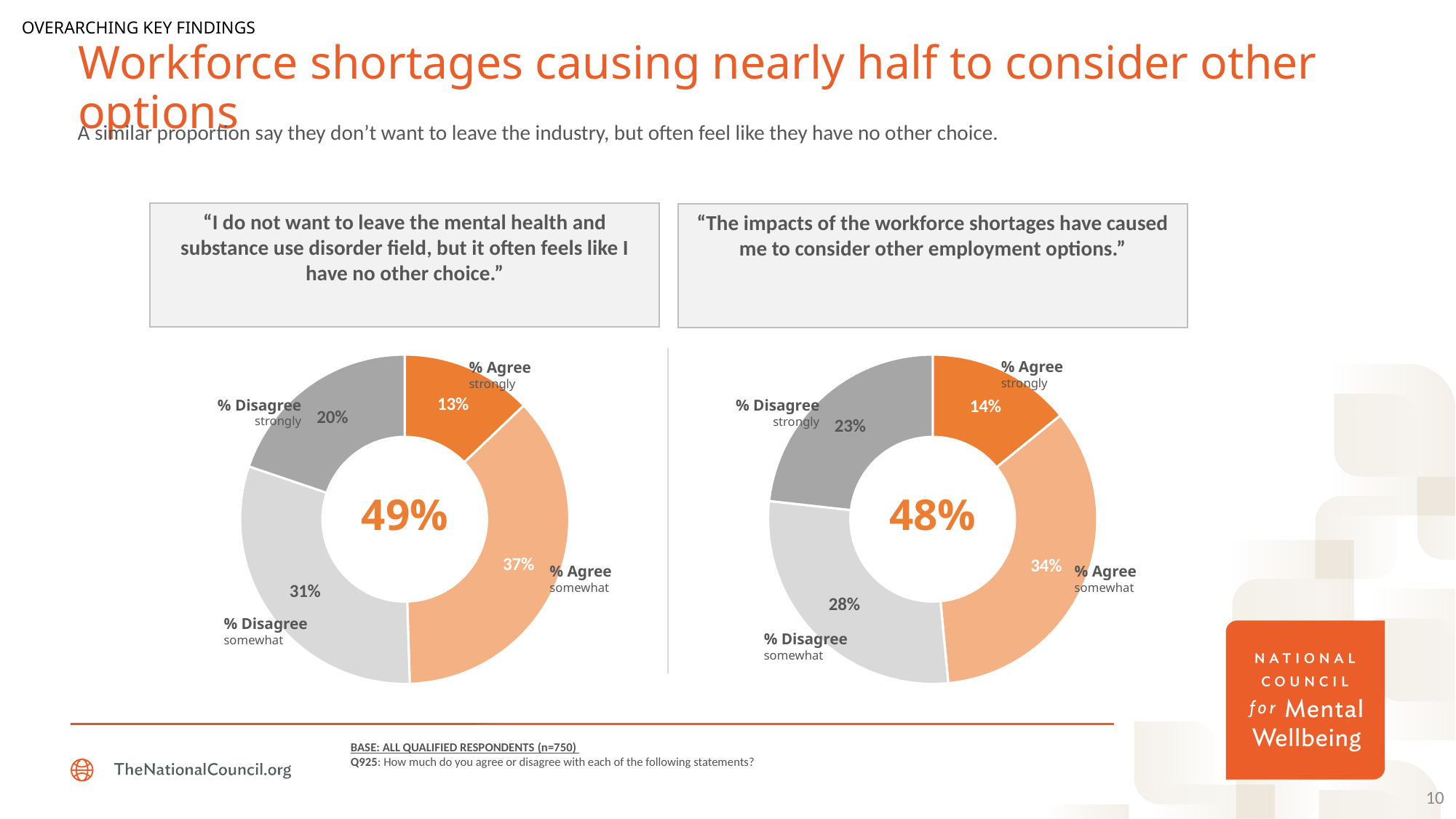
In the left chart ("I do not want to leave..."), what percentage of respondents agree strongly? 13% How many response categories does each donut chart on the slide show? 4 In the left chart ("I do not want to leave the mental health and substance use disorder field..."), what percentage of respondents agree somewhat? 37% Is the % Agree somewhat share larger in the left chart ("I do not want to leave...") or the right chart ("The impacts of the workforce shortages...")? Left chart In the left chart ("I do not want to leave..."), which response category has the largest share? % Agree somewhat In the right chart ("The impacts of the workforce shortages..."), what is the combined share of % Agree strongly and % Agree somewhat? 48% In the right chart ("The impacts of the workforce shortages have caused me to consider other employment options"), what percentage of respondents disagree strongly? 23% In the right chart ("The impacts of the workforce shortages..."), what percentage of respondents disagree somewhat? 28% In the right chart ("The impacts of the workforce shortages..."), which response category has the smallest share? % Agree strongly What type of chart is used on this slide? Donut (pie) chart What number is displayed in the center of the right chart ("The impacts of the workforce shortages...")? 48% In the left chart ("I do not want to leave..."), what is the difference between the % Disagree somewhat and % Disagree strongly shares? 11%